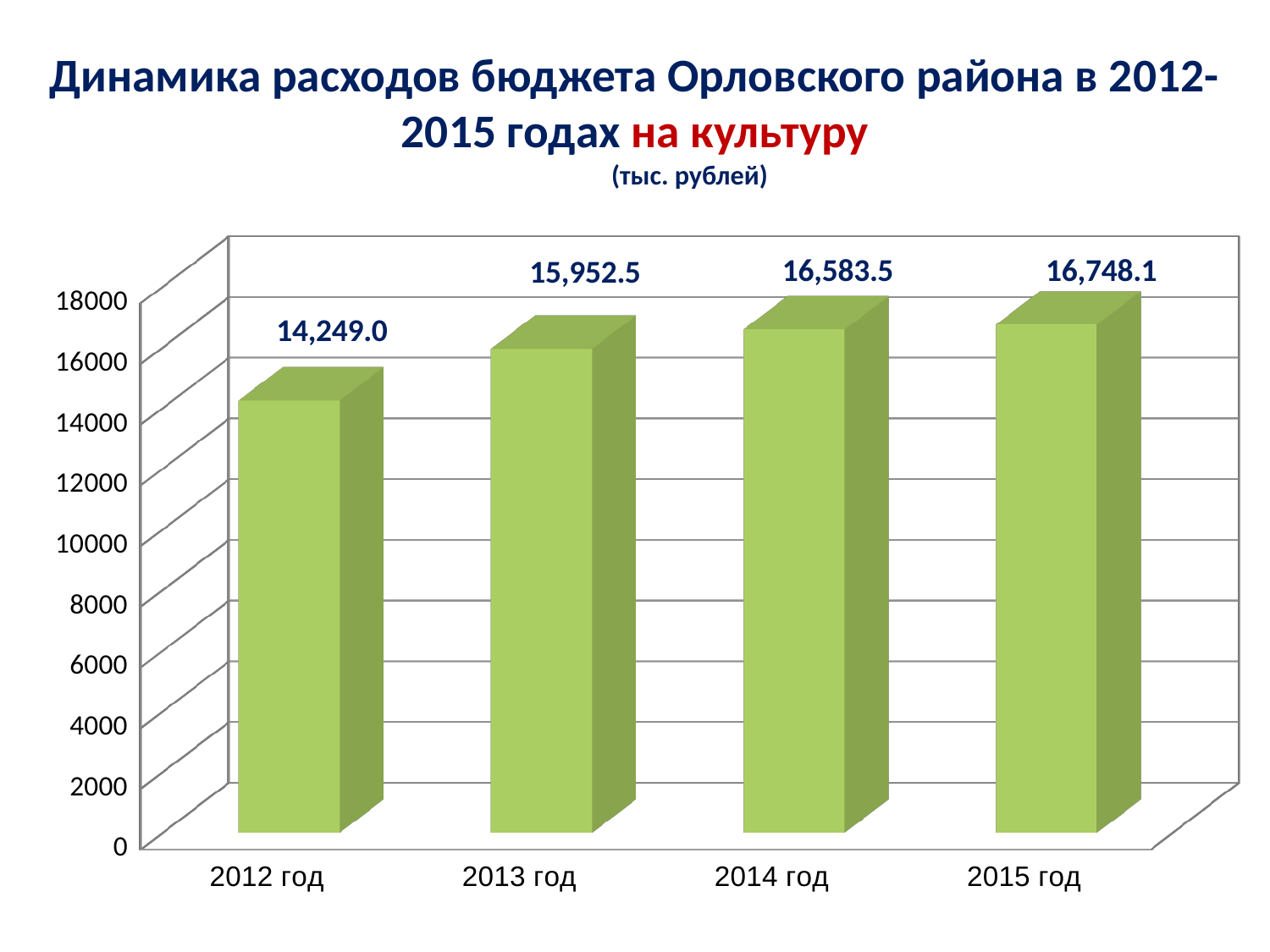
Which year has the highest value? 2015 год What is the value for 2015 год? 16,748.1 What is the value for 2014 год? 16,583.5 Which year has the lowest value? 2012 год Which is larger, the value for 2013 год or the value for 2014 год? 2014 год What is the difference between the values for 2013 год and 2012 год? 1,703.5 How many years are shown on the chart? 4 Do the values rise or fall from 2012 год to 2015 год? rise What is the value for 2012 год? 14,249.0 What is the difference between the values for 2015 год and 2014 год? 164.6 What kind of chart is shown on the slide? bar chart Is the value for 2013 год greater or less than 16000? less